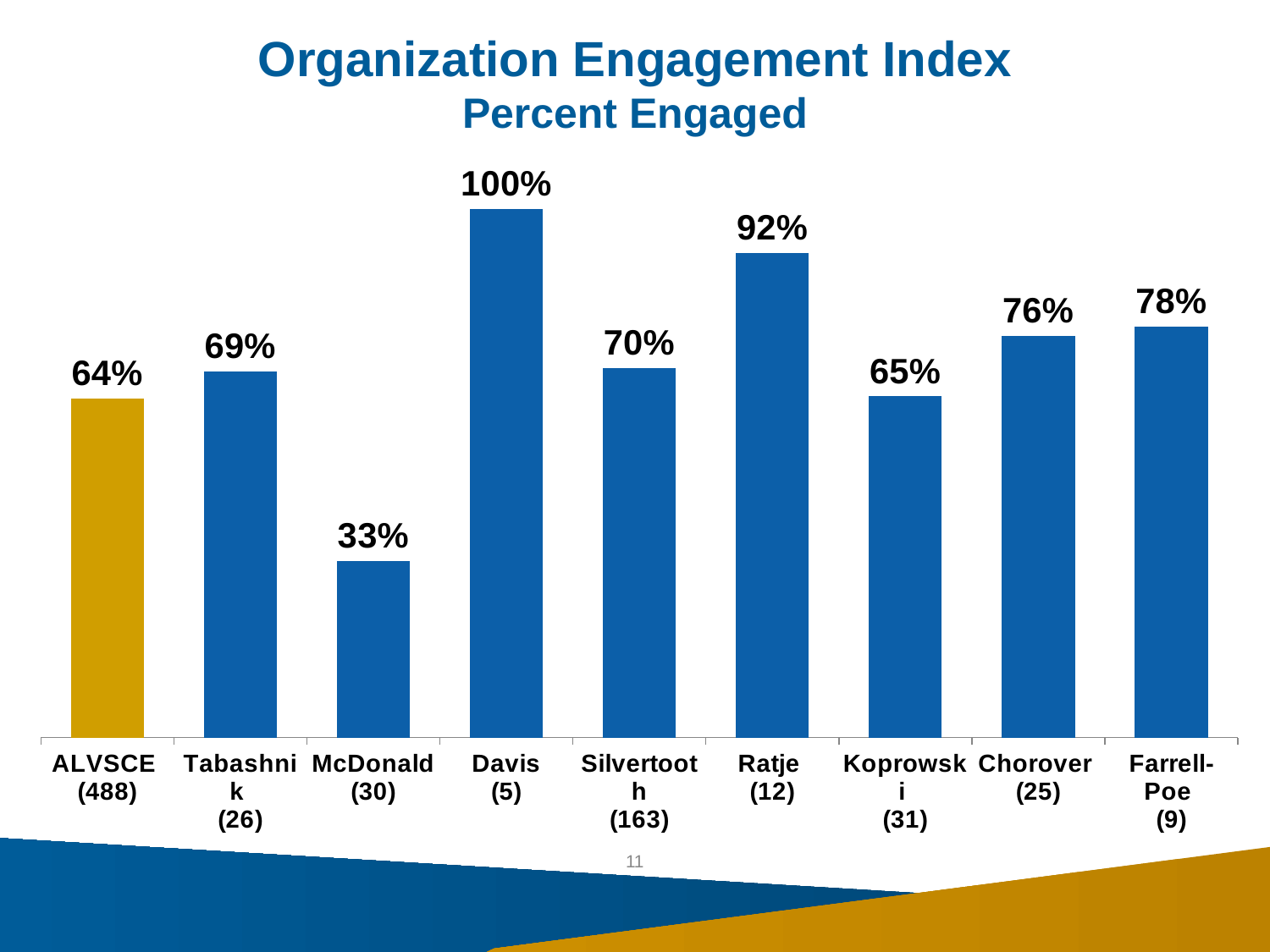
What is the percent engaged for Silvertooth? 70% What is the difference in percent engaged between Farrell-Poe and ALVSCE? 14% Which bar is shown in a different colour (gold) from the others? ALVSCE How many categories are shown in the chart? 9 Which category has the lowest percent engaged? McDonald Which category has the highest percent engaged? Davis What is the percent engaged for ALVSCE? 64% What is the percent engaged for Chorover? 76% What kind of chart is shown on the slide? Bar chart What is the title of the chart? Organization Engagement Index Percent Engaged What is the difference in percent engaged between Ratje and Koprowski? 27% Which has a higher percent engaged, Tabashnik or Chorover? Chorover